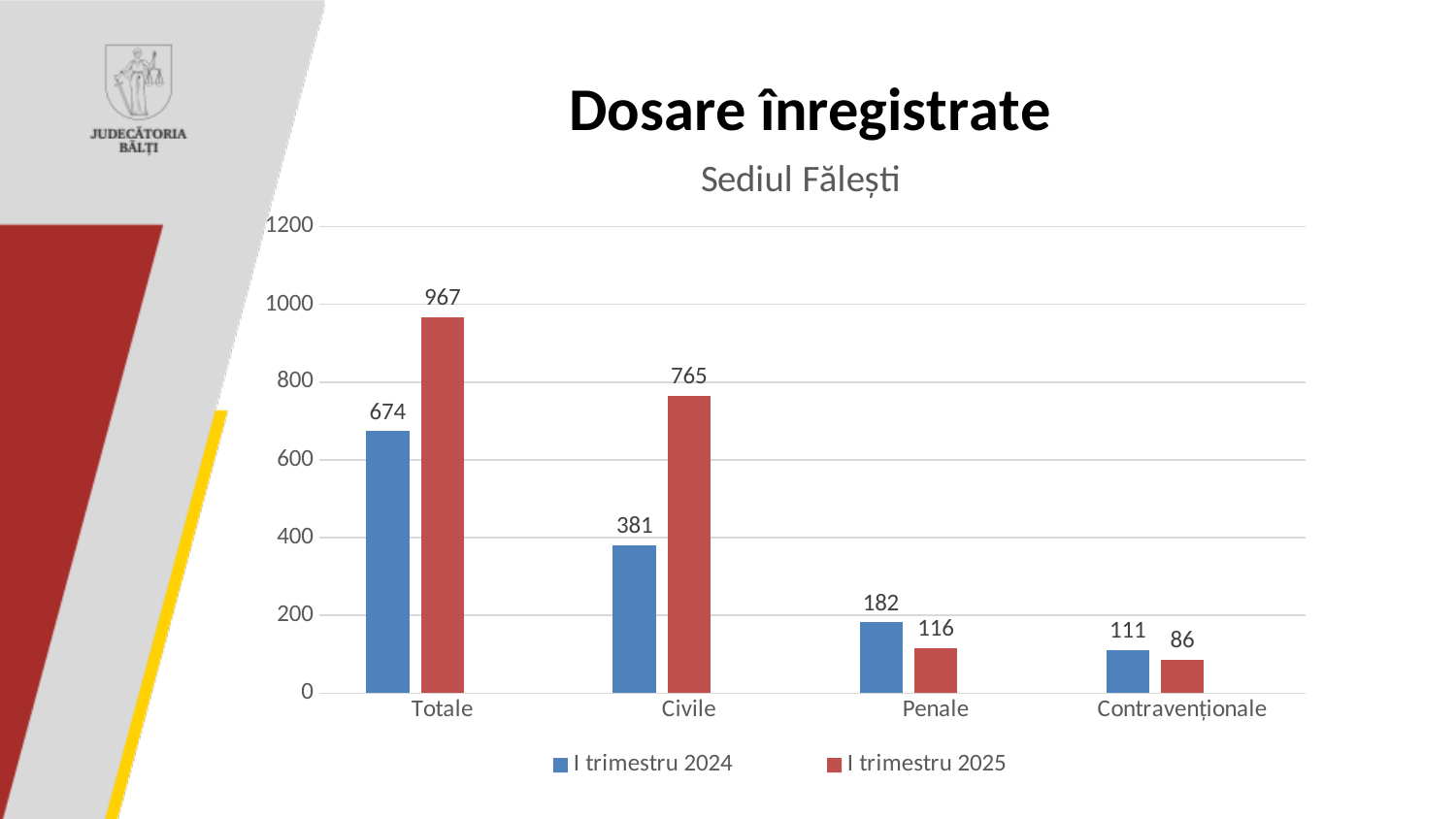
Which category has the lowest value in the I trimestru 2025 series? Contravenționale How many series does the legend list? 2 What is the value for Penale in the I trimestru 2025 series? 116 How many categories are shown on the x axis? 4 What is the difference between the I trimestru 2025 and I trimestru 2024 values for Totale? 293 Which category has the highest value in the I trimestru 2024 series? Totale What is the value for Civile in the I trimestru 2024 series? 381 What is the value for Contravenționale in the I trimestru 2024 series? 111 What is the value for Totale in the I trimestru 2025 series? 967 What is the difference between the I trimestru 2024 and I trimestru 2025 values for Penale? 66 What kind of chart is shown on the slide? Bar chart Which is larger for Civile: I trimestru 2024 or I trimestru 2025? I trimestru 2025